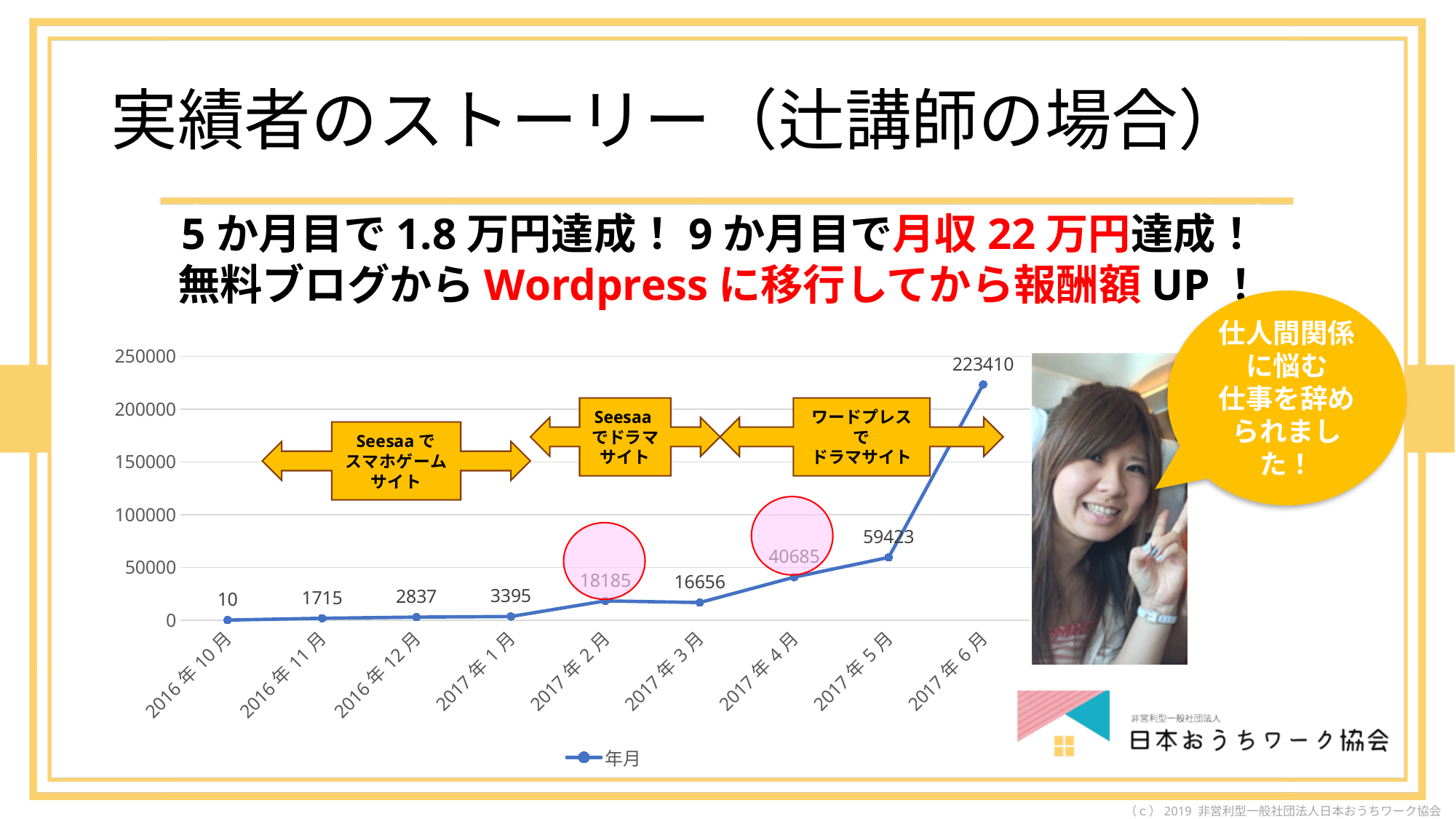
How many data points are plotted on the line? 9 What is the legend entry for the plotted series? 年月 What type of chart is shown on the slide? line chart Which is larger, the value for 2017年2月 or the value for 2017年3月? 2017年2月 What is the value for 2017年4月? 40685 What is the value for 2016年12月? 2837 How many series does the legend list? 1 What is the value for 2017年6月? 223410 What is the value for 2017年2月? 18185 Which month has the lowest value? 2016年10月 What is the difference between the values for 2017年5月 and 2017年4月? 18738 Which month has the highest value? 2017年6月